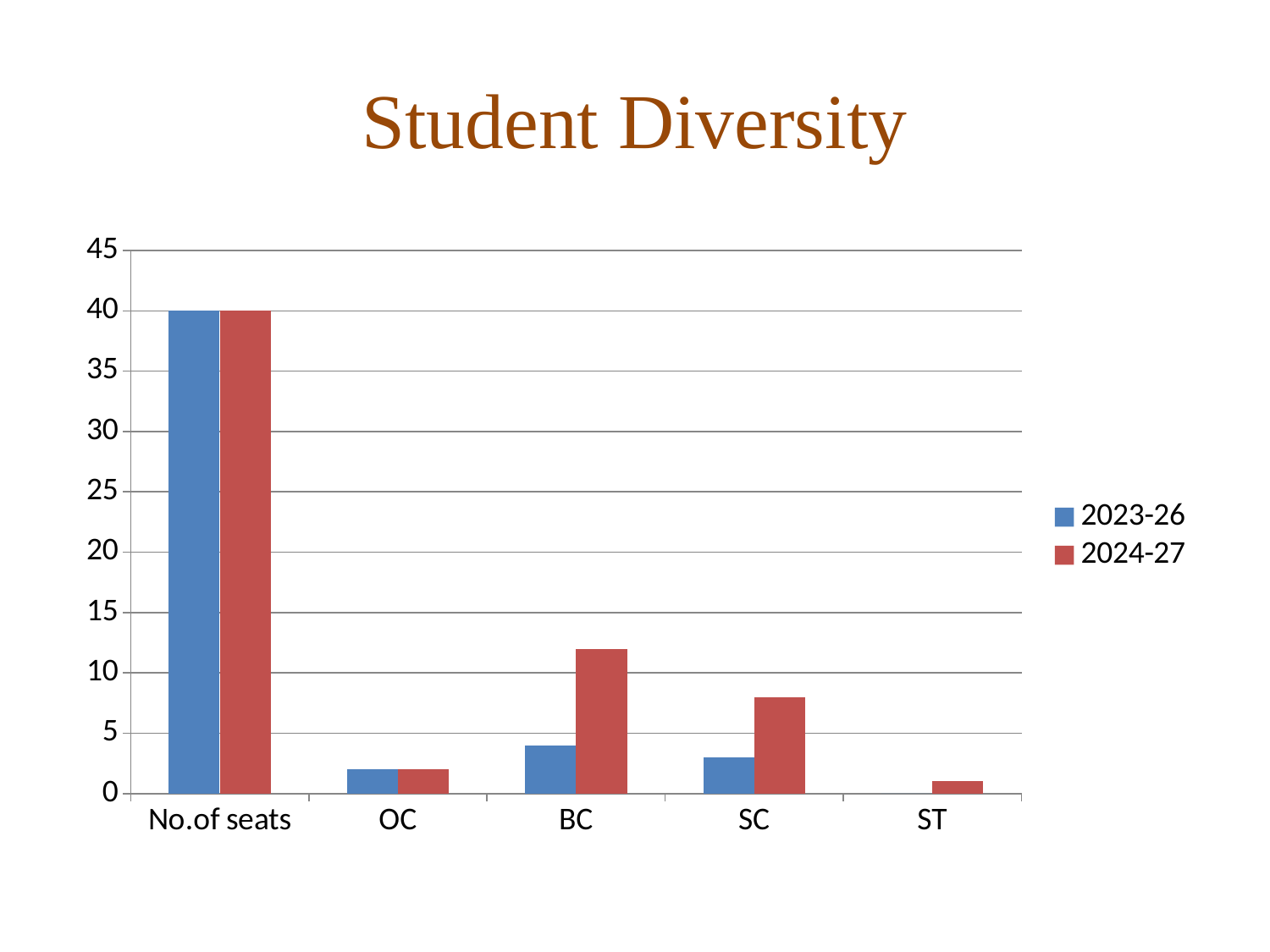
Which legend entry is shown in red? 2024-27 Is the value for BC in the 2024-27 series greater or less than 10? greater How many series does the legend list? 2 How many categories are shown on the x axis? 5 Which category has the lowest value in the 2023-26 series? ST What is the title of the slide? Student Diversity For BC, which series has the larger value, 2023-26 or 2024-27? 2024-27 What is the value for No.of seats in the 2023-26 series? 40 Is the value for SC in the 2023-26 series greater or less than 5? less What type of chart is shown on the slide? bar chart Which category has the highest value in the 2024-27 series? No.of seats What is the value for No.of seats in the 2024-27 series? 40